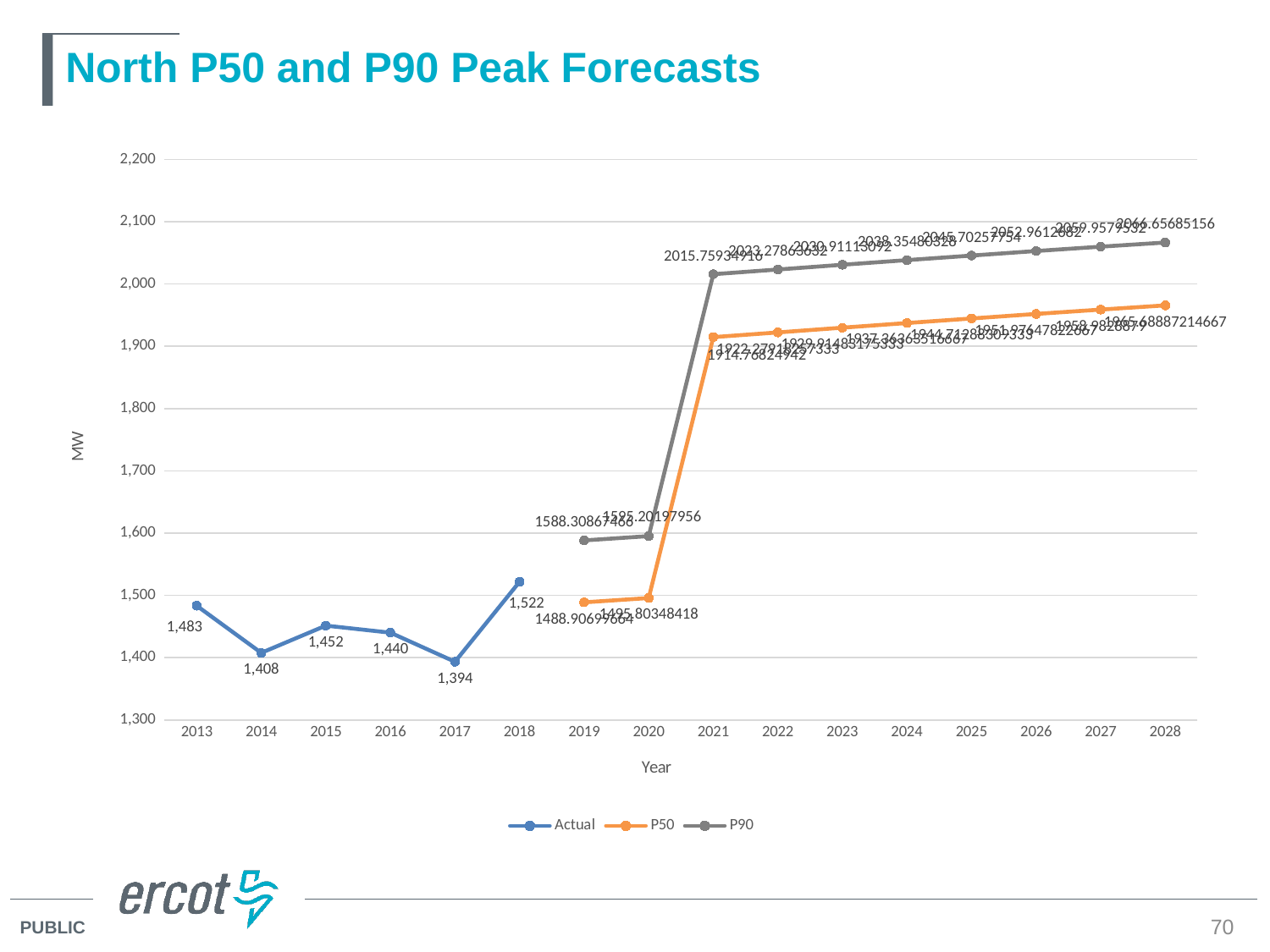
Is the P50 value for 2021 greater or less than 2,000? less In which year is the Actual series lowest? 2017 How many years are shown on the x axis? 16 Which year has the larger Actual value, 2015 or 2016? 2015 What is the Actual value for 2017? 1,394 How many series does the legend list? 3 Is the P90 value for 2021 greater or less than 2,000? greater What kind of chart is shown on the slide? line chart In which year is the Actual series highest? 2018 What is the Actual value for 2013? 1,483 What is the label on the y axis? MW What is the difference between the Actual values for 2018 and 2017? 128